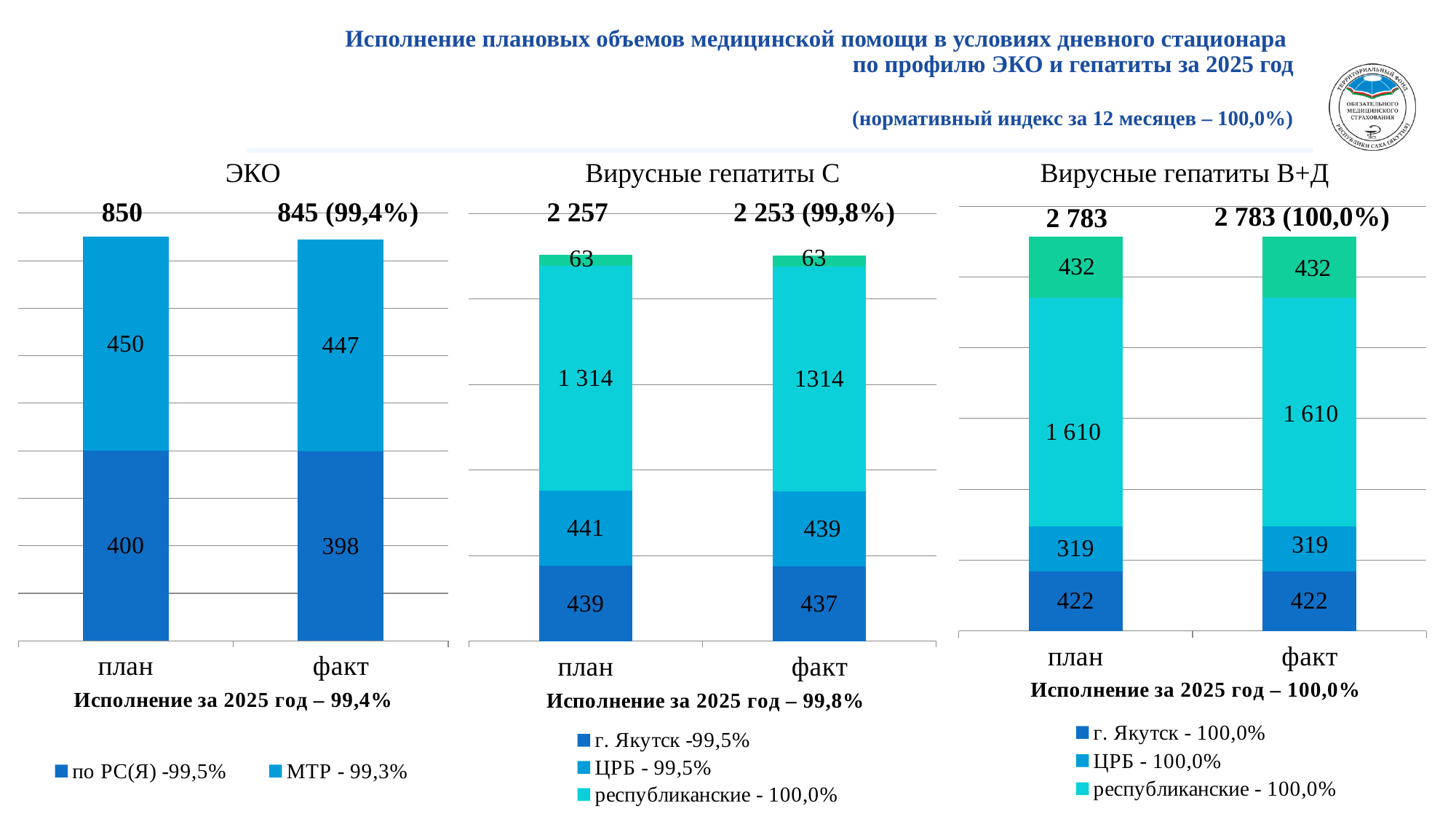
In the Вирусные гепатиты С chart, what is the total of the план stacked bar? 2 257 How many series does the legend of the ЭКО chart list? 2 In the Вирусные гепатиты С chart, what is the value of the республиканские segment for план? 1 314 In the Вирусные гепатиты В+Д chart, which is larger: the ЦРБ segment for план or the г. Якутск segment for план? г. Якутск In the ЭКО chart, what is the difference between the по РС(Я) segment for план and for факт? 2 In the ЭКО chart, what is the value of the МТР segment for план? 450 In the Вирусные гепатиты В+Д chart, what is the value of the г. Якутск segment for план? 422 In the ЭКО chart, what is the value of the по РС(Я) segment for факт? 398 In the Вирусные гепатиты С chart, which segment of the факт bar is the largest? республиканские In the Вирусные гепатиты С chart, what is the value of the ЦРБ segment for факт? 439 In the Вирусные гепатиты В+Д chart, what is the total of the факт stacked bar? 2 783 In the ЭКО chart, what is the total of the факт stacked bar? 845